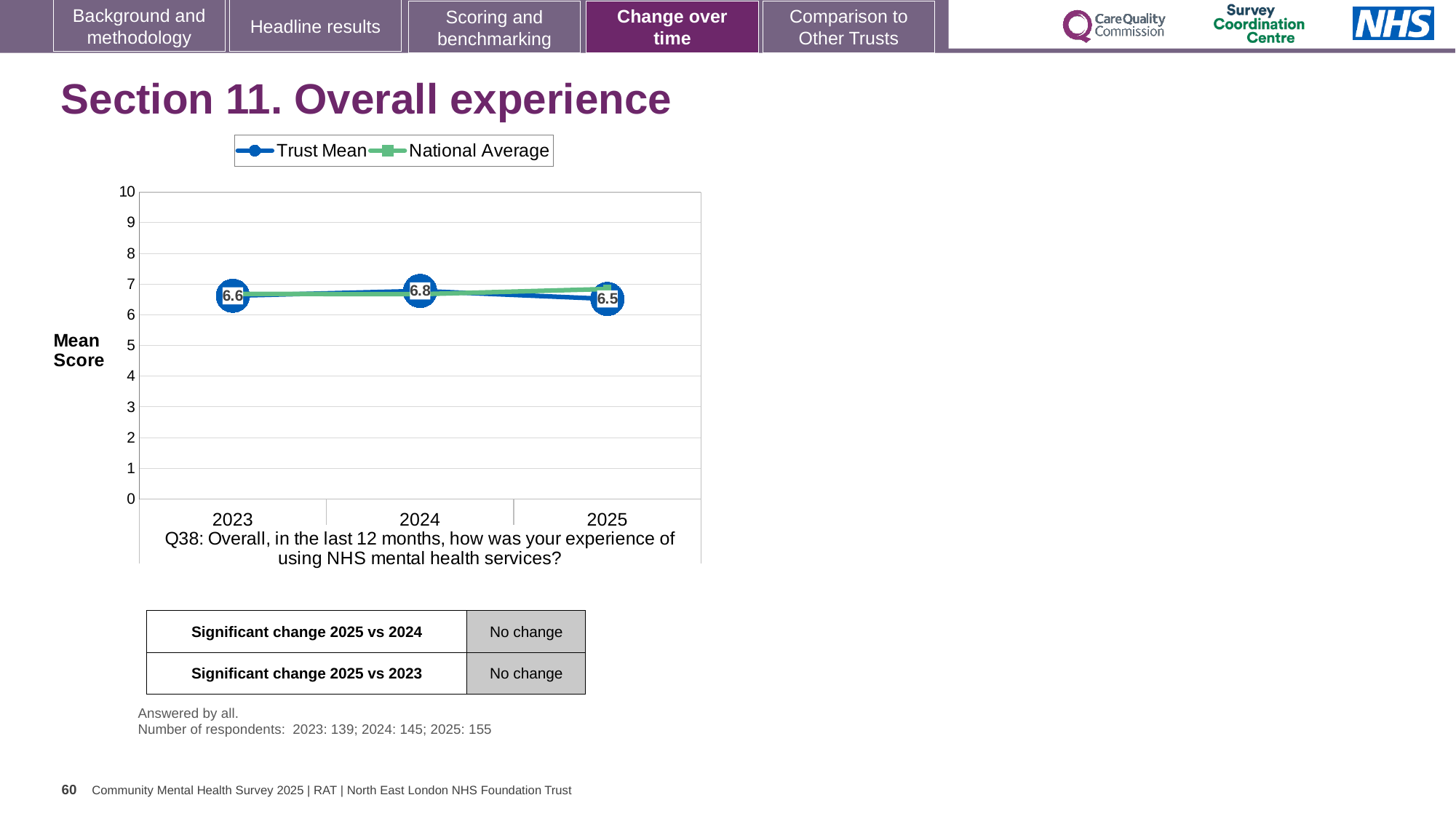
What is the difference between the Trust Mean in 2024 and in 2025? 0.3 In which year is the Trust Mean highest? 2024 Is the Trust Mean for 2025 greater or less than 7? less What kind of chart is shown? line chart How many years are plotted on the x axis? 3 What is the Trust Mean score for 2023? 6.6 In which year is the Trust Mean lowest? 2025 What is the Trust Mean score for 2025? 6.5 Which is larger, the Trust Mean for 2023 or for 2024? 2024 What is the Trust Mean score for 2024? 6.8 What is the label of the y axis? Mean Score How many series does the legend list? 2